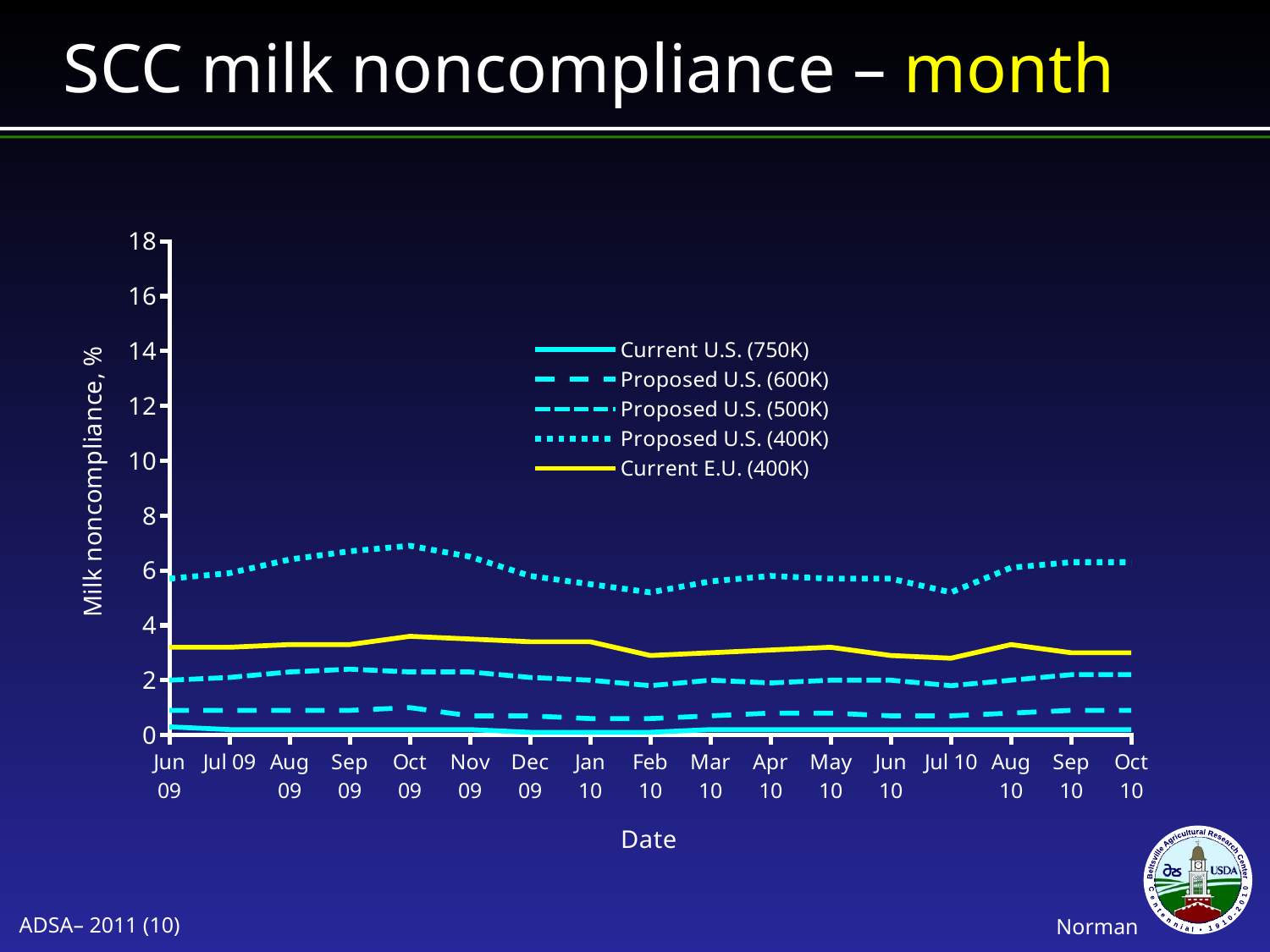
Is the value for Current E.U. (400K) in Oct 09 greater or less than 4? less Is the value for Proposed U.S. (400K) in Oct 09 greater or less than 6? greater Is the value for Current U.S. (750K) in Jun 09 greater or less than 2? less Which series has the highest milk noncompliance across the whole period? Proposed U.S. (400K) Which series has the lowest milk noncompliance across the whole period? Current U.S. (750K) In Jun 09, which is larger: Proposed U.S. (400K) or Current E.U. (400K)? Proposed U.S. (400K) What is the label of the y axis? Milk noncompliance, % How many series does the legend list? 5 Which series is drawn in yellow? Current E.U. (400K) How many months are shown along the x axis? 17 What kind of chart is shown on the slide? line chart